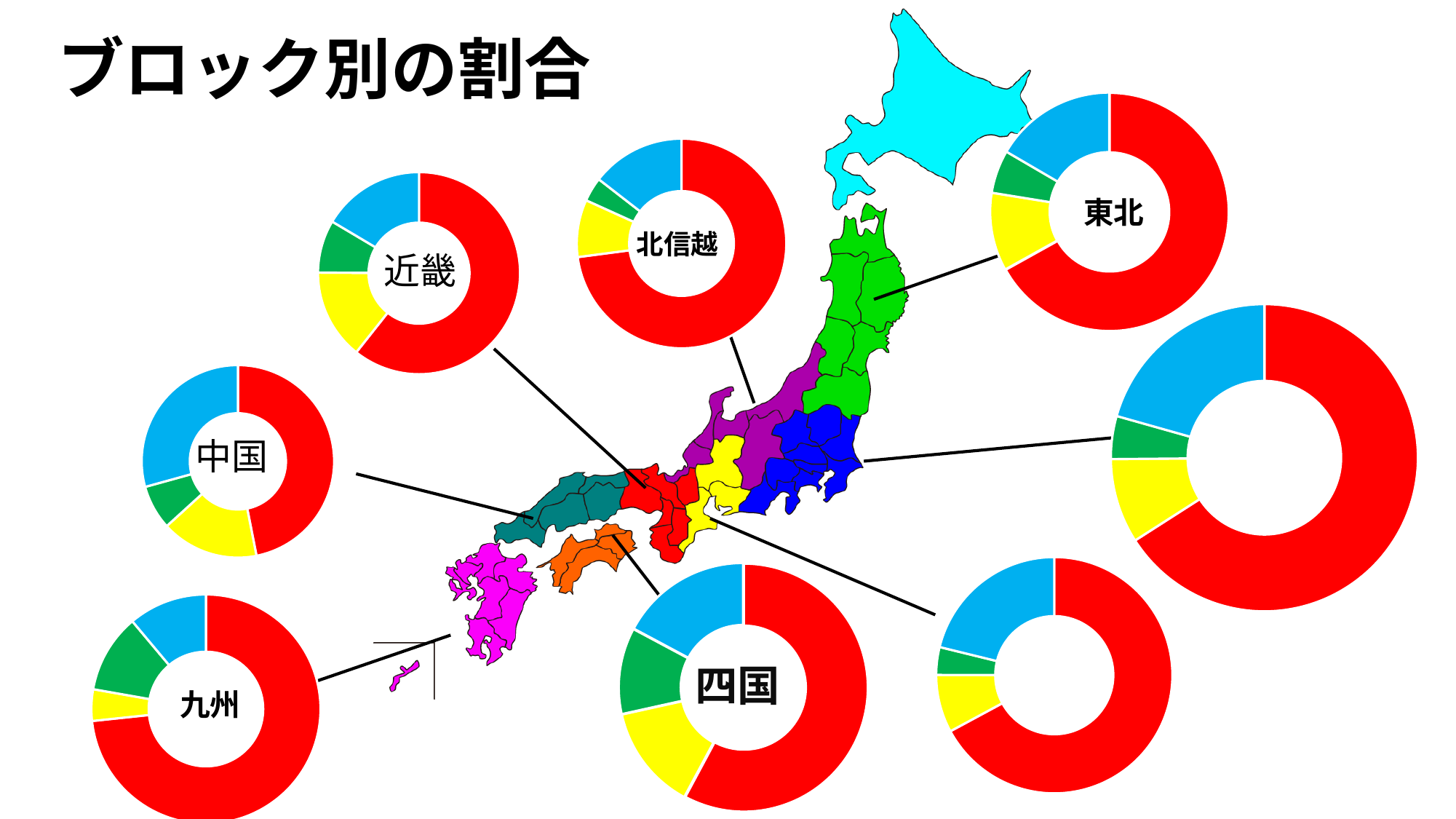
What is the title of the slide? ブロック別の割合 In the 中国 chart, which slice is larger, the blue one or the green one? blue In the 九州 chart, which slice is larger, the green one or the yellow one? green In the 東北 chart, which colour slice is the largest? red How many donut charts are shown on the slide? 8 In the 九州 chart, which colour slice is the smallest? yellow How many slices does the 近畿 donut chart have? 4 In the 北信越 chart, which colour slice is the largest? red In the 四国 chart, which slice is larger, the red one or the blue one? red How many slices does the 四国 donut chart have? 4 In the 中国 chart, which colour slice is the smallest? green What kind of chart is the 近畿 chart? donut (pie) chart